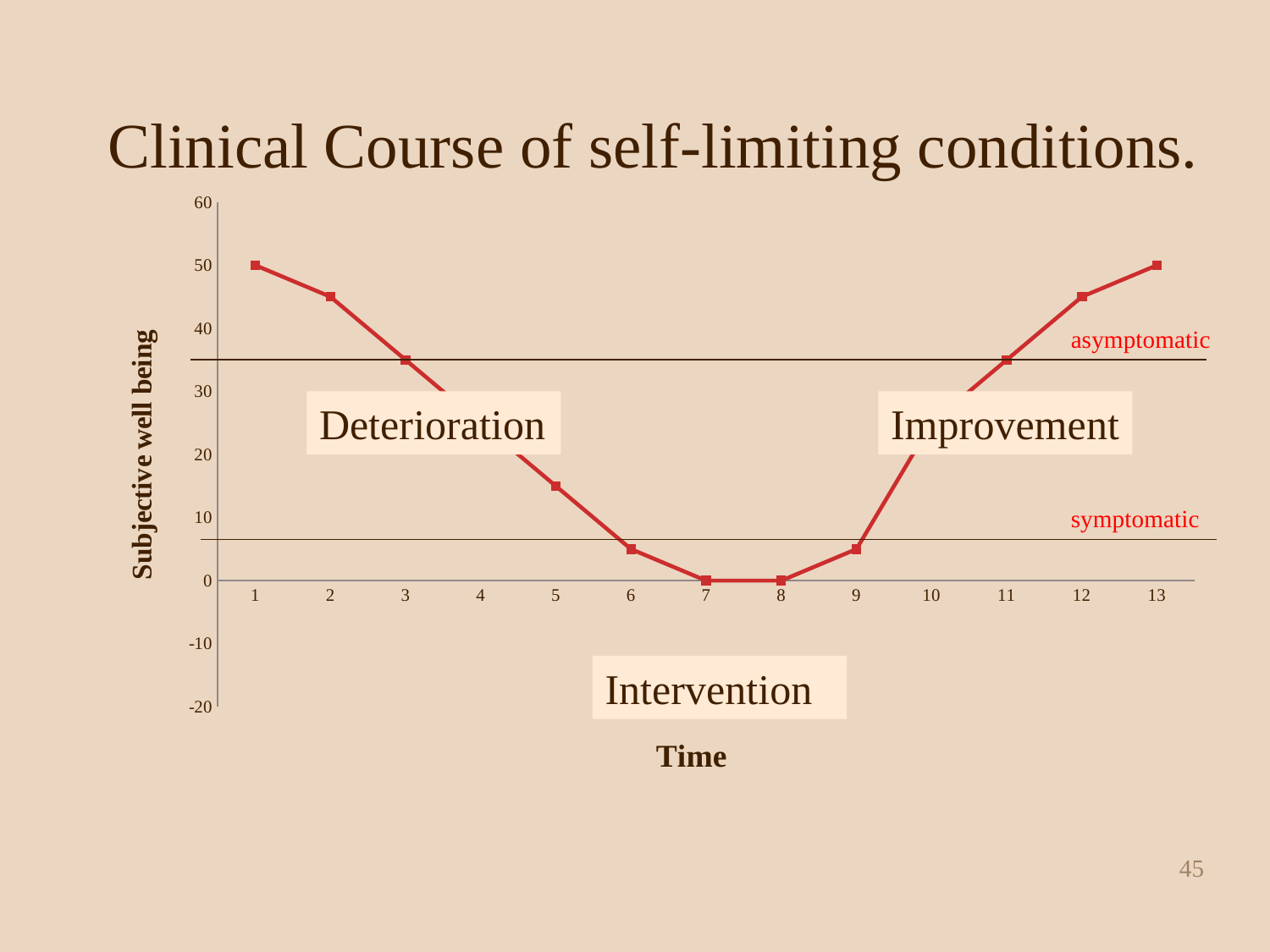
What is the subjective well being value at time 7? 0 What kind of chart is shown on the slide? line chart How many time points are labelled on the x axis? 13 What is the title of the vertical axis? Subjective well being Is the value at time 11 greater or less than 30? greater Is the value at time 5 greater or less than 20? less Do the values rise or fall from time 8 to time 13? rise What is the subjective well being value at time 1? 50 Which is larger, the value at time 3 or the value at time 6? time 3 Do the values rise or fall from time 1 to time 7? fall What is the subjective well being value at time 13? 50 Is the value at time 2 greater or less than 40? greater